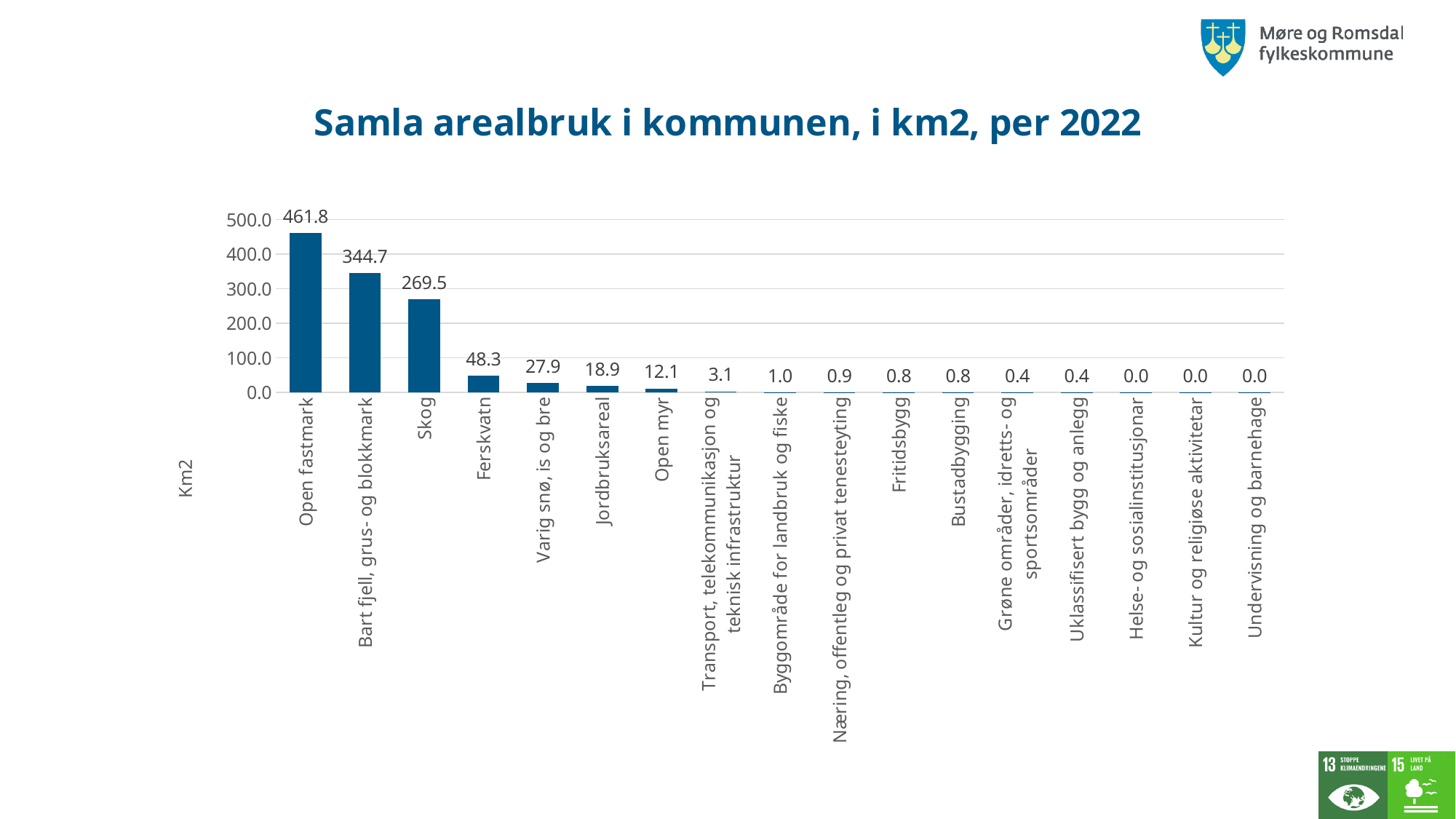
What is the value for Transport, telekommunikasjon og teknisk infrastruktur? 3.1 How many categories are shown on the x axis? 17 Which is larger, Varig snø, is og bre or Open myr? Varig snø, is og bre What is the value for Jordbruksareal? 18.9 What is the title of the chart? Samla arealbruk i kommunen, i km2, per 2022 What is the difference between Open fastmark and Bart fjell, grus- og blokkmark? 117.1 What kind of chart is shown on the slide? Bar chart Which category has the highest value? Open fastmark What is the value for Skog? 269.5 What is the difference between Skog and Ferskvatn? 221.2 What is the value for Ferskvatn? 48.3 What is the value for Open fastmark? 461.8